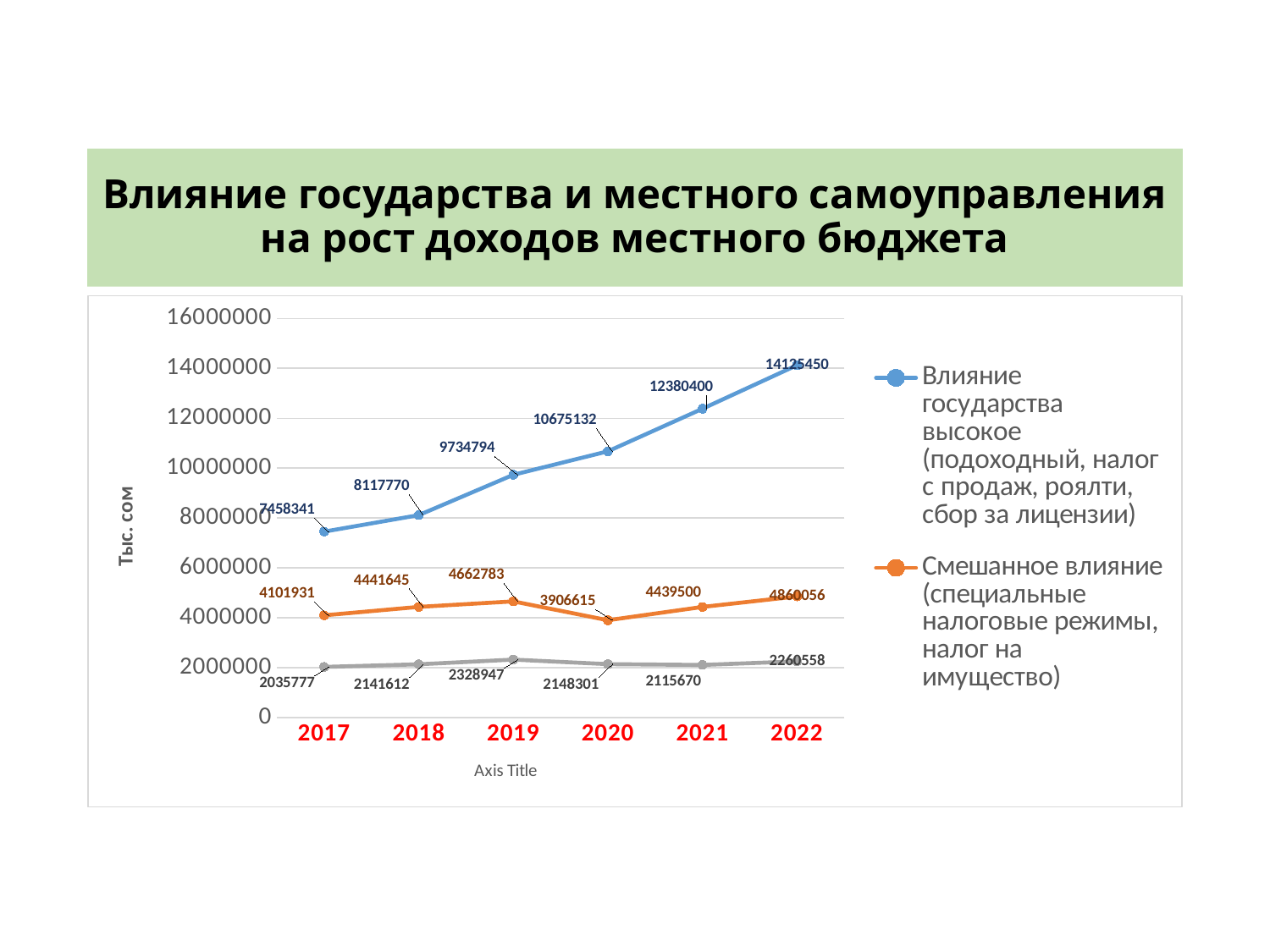
What kind of chart is shown on the slide? line chart What is the difference between the 2019 and 2018 values of the series 'Смешанное влияние'? 221138 How many series does the legend list? 2 What is the value for 2017 in the series 'Влияние государства высокое'? 7458341 What is the value for 2019 in the series 'Смешанное влияние'? 4662783 In 2019, which series has the larger value: 'Влияние государства высокое' or 'Смешанное влияние'? Влияние государства высокое What is the difference between the 2022 and 2021 values of the series 'Влияние государства высокое'? 1745050 How many years are shown on the x axis? 6 What is the value for 2020 in the series 'Смешанное влияние'? 3906615 What is the value for 2022 in the series 'Влияние государства высокое'? 14125450 In which year is the series 'Влияние государства высокое' highest? 2022 In which year is the series 'Смешанное влияние' lowest? 2020